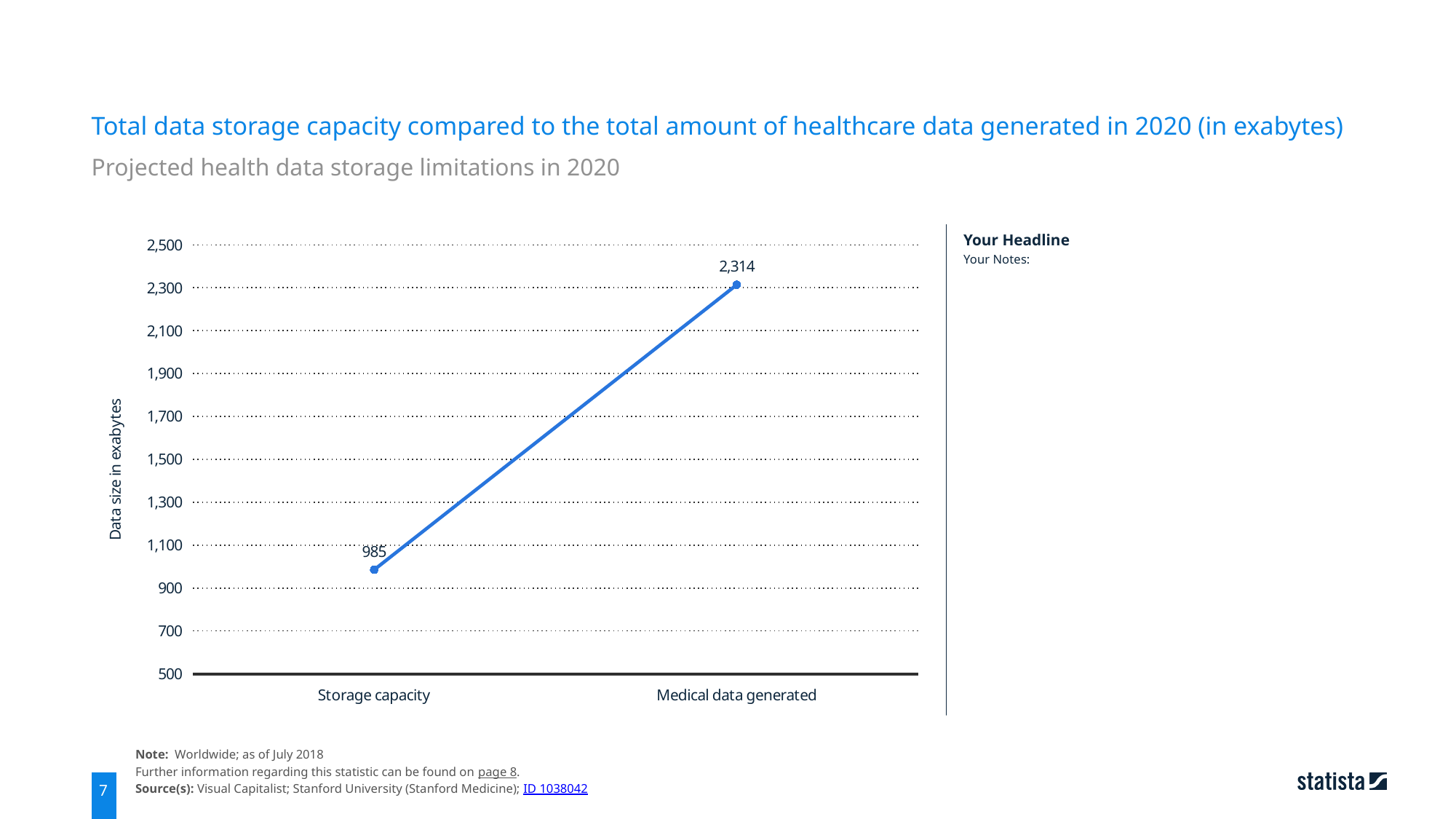
Is the value for Storage capacity greater or less than 1,100? less How many categories are plotted on the x axis? 2 Do the values rise or fall from Storage capacity to Medical data generated? rise Which category has the highest value? Medical data generated What kind of chart is shown on the slide? line chart What is the value for Medical data generated? 2,314 Which category has the lowest value? Storage capacity What is the value for Storage capacity? 985 What is the difference between the value for Medical data generated and the value for Storage capacity? 1,329 What is the label of the y axis? Data size in exabytes Is the value for Medical data generated greater or less than 2,100? greater Which is larger, the value for Storage capacity or the value for Medical data generated? Medical data generated